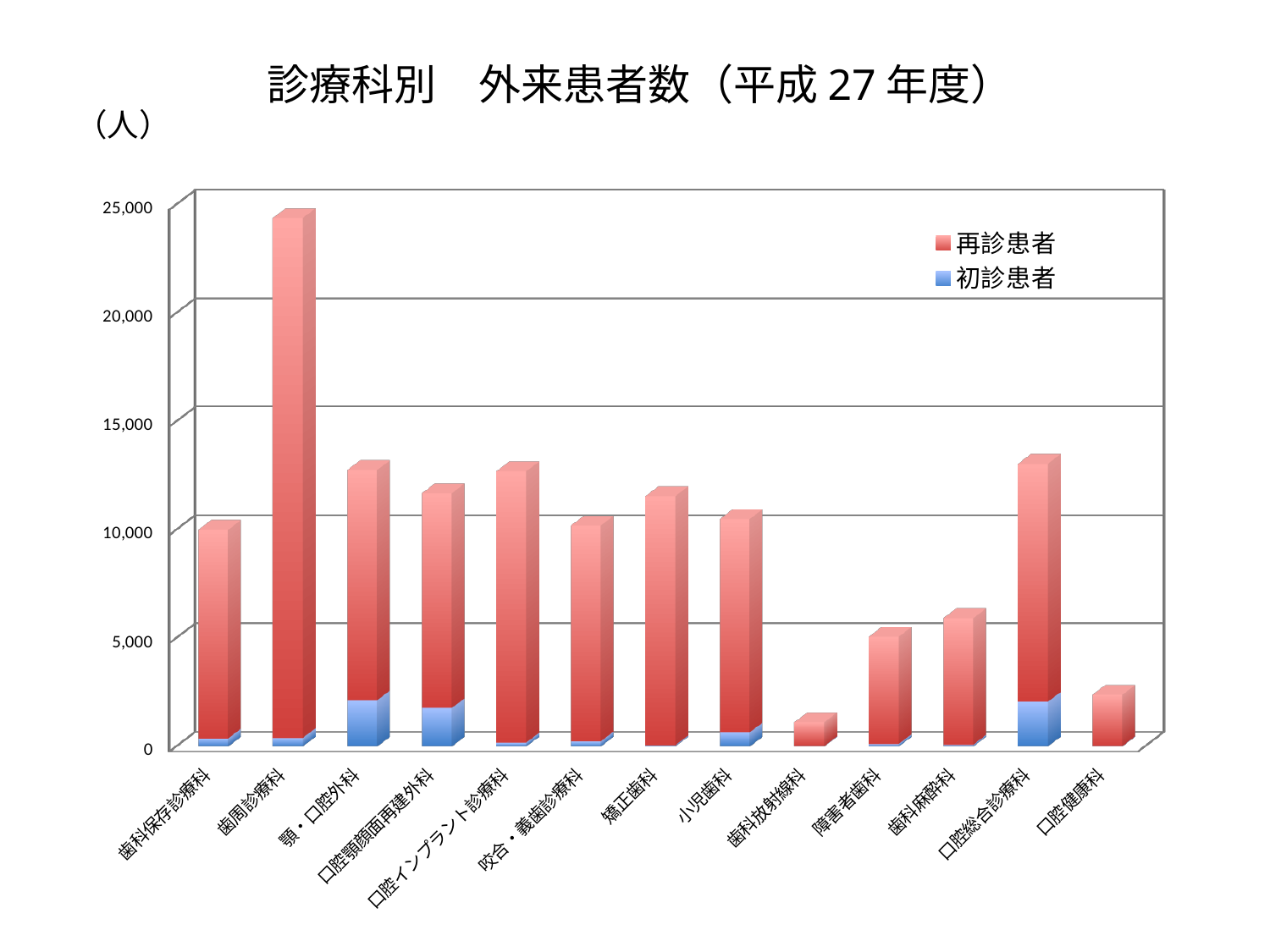
Is the total value for 歯科放射線科 greater or less than 5,000? less How many series does the legend list? 2 What kind of chart is shown on the slide? bar chart Is the total value for 歯周診療科 greater or less than 20,000? greater Is the total value for 口腔健康科 greater or less than 5,000? less How many departments (categories) are shown on the x axis? 13 Which department has the lowest total number of outpatients? 歯科放射線科 What is the title of the chart? 診療科別 外来患者数（平成27年度） Which has a larger total number of outpatients, 口腔健康科 or 歯科放射線科? 口腔健康科 Which has a larger total number of outpatients, 歯周診療科 or 口腔総合診療科? 歯周診療科 Which department has the highest total number of outpatients? 歯周診療科